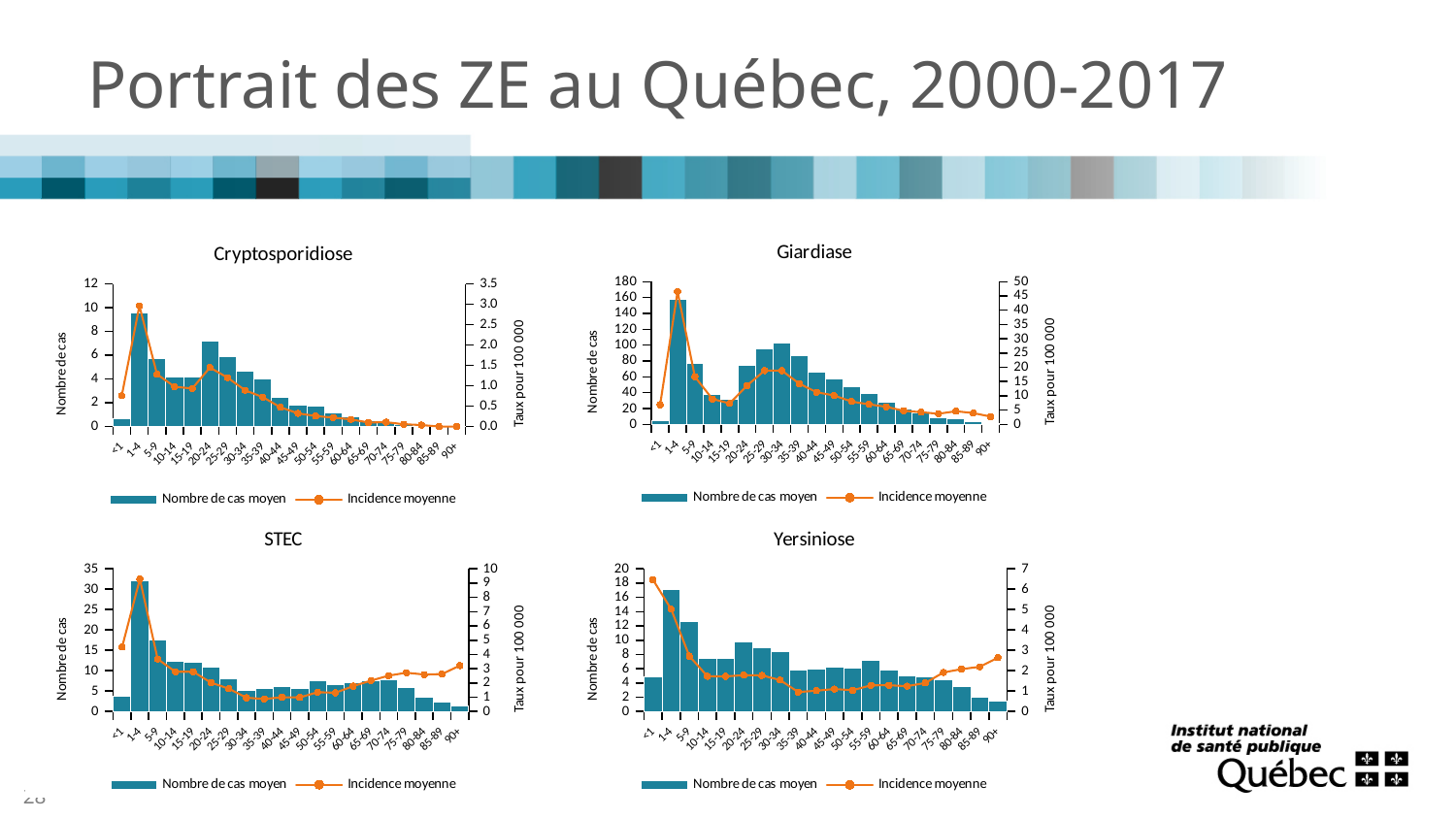
In the Yersiniose chart, is the number of cases for the 1-4 age group greater or less than 15? greater In the Yersiniose chart, which age group has the highest number of cases? 1-4 In the STEC chart, does the Incidence moyenne line rise or fall from the 60-64 age group to the 90+ age group? rises In the Giardiase chart, which age group has the highest number of cases (Nombre de cas moyen)? 1-4 In the Cryptosporidiose chart, is the number of cases for the 1-4 age group greater or less than 8? greater In the Giardiase chart, is the number of cases for the 1-4 age group greater or less than 140? greater In the STEC chart, which age group has the highest bar? 1-4 How many age-group categories are shown on the x axis of the STEC chart? 20 How many series does the legend of the Giardiase chart list? 2 In the Giardiase chart, which age group has more cases, 20-24 or 30-34? 30-34 What kind of chart is the Cryptosporidiose chart? A combined bar and line chart What is the title of the right-hand vertical axis on the Yersiniose chart? Taux pour 100 000